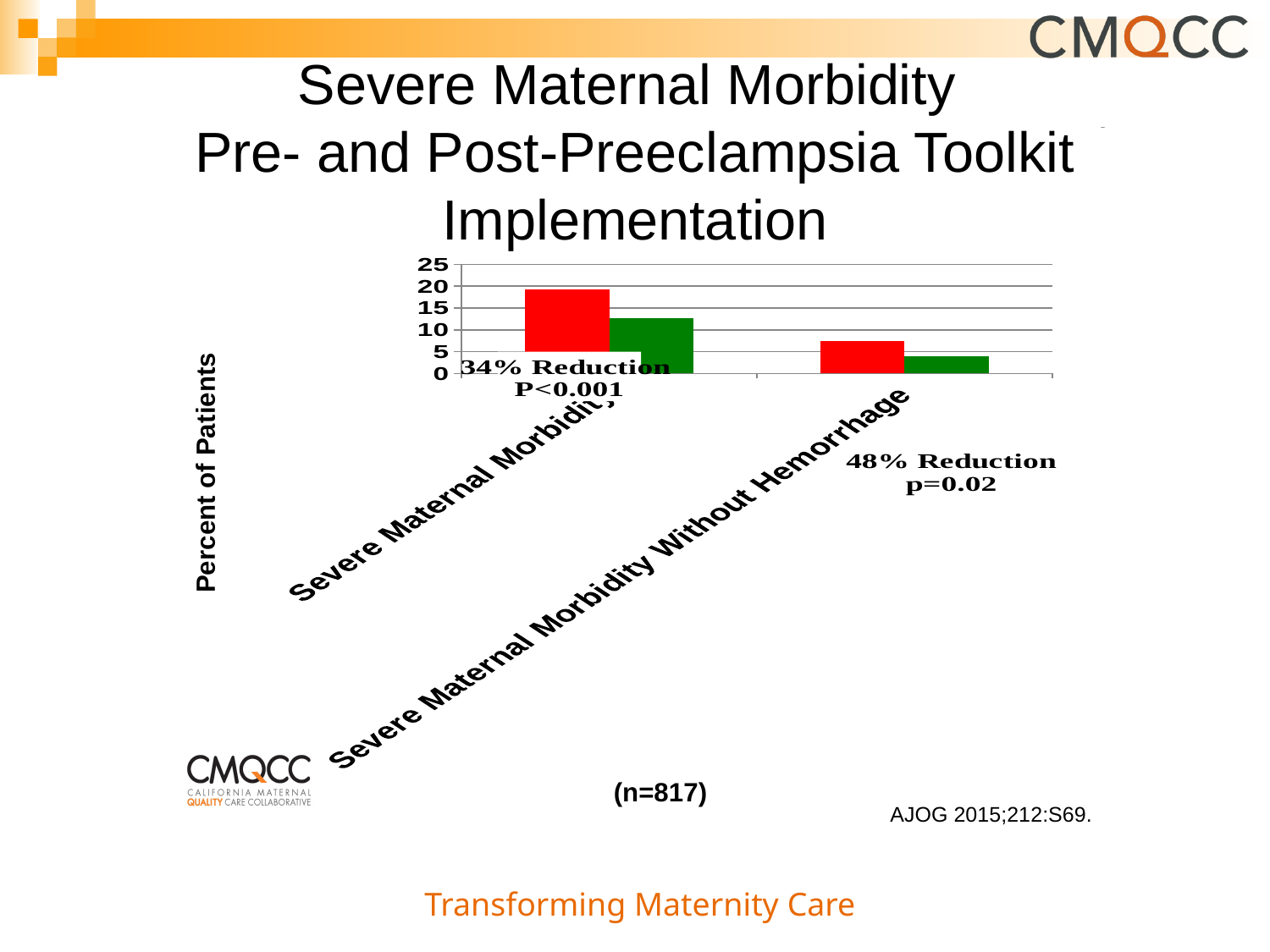
Is the value of the red bar for Severe Maternal Morbidity Without Hemorrhage greater or less than 10? less Which is larger for Severe Maternal Morbidity: the red bar or the green bar? the red bar What kind of chart is shown on the slide? bar chart Which category has the lowest green bar? Severe Maternal Morbidity Without Hemorrhage What reduction is annotated for the Severe Maternal Morbidity category? 34% Reduction Which category has the highest red bar? Severe Maternal Morbidity Is the value of the green bar for Severe Maternal Morbidity greater or less than 15? less Is the value of the red bar for Severe Maternal Morbidity greater or less than 15? greater How many categories are shown on the x axis of the chart? 2 What is the label of the y axis of the chart? Percent of Patients